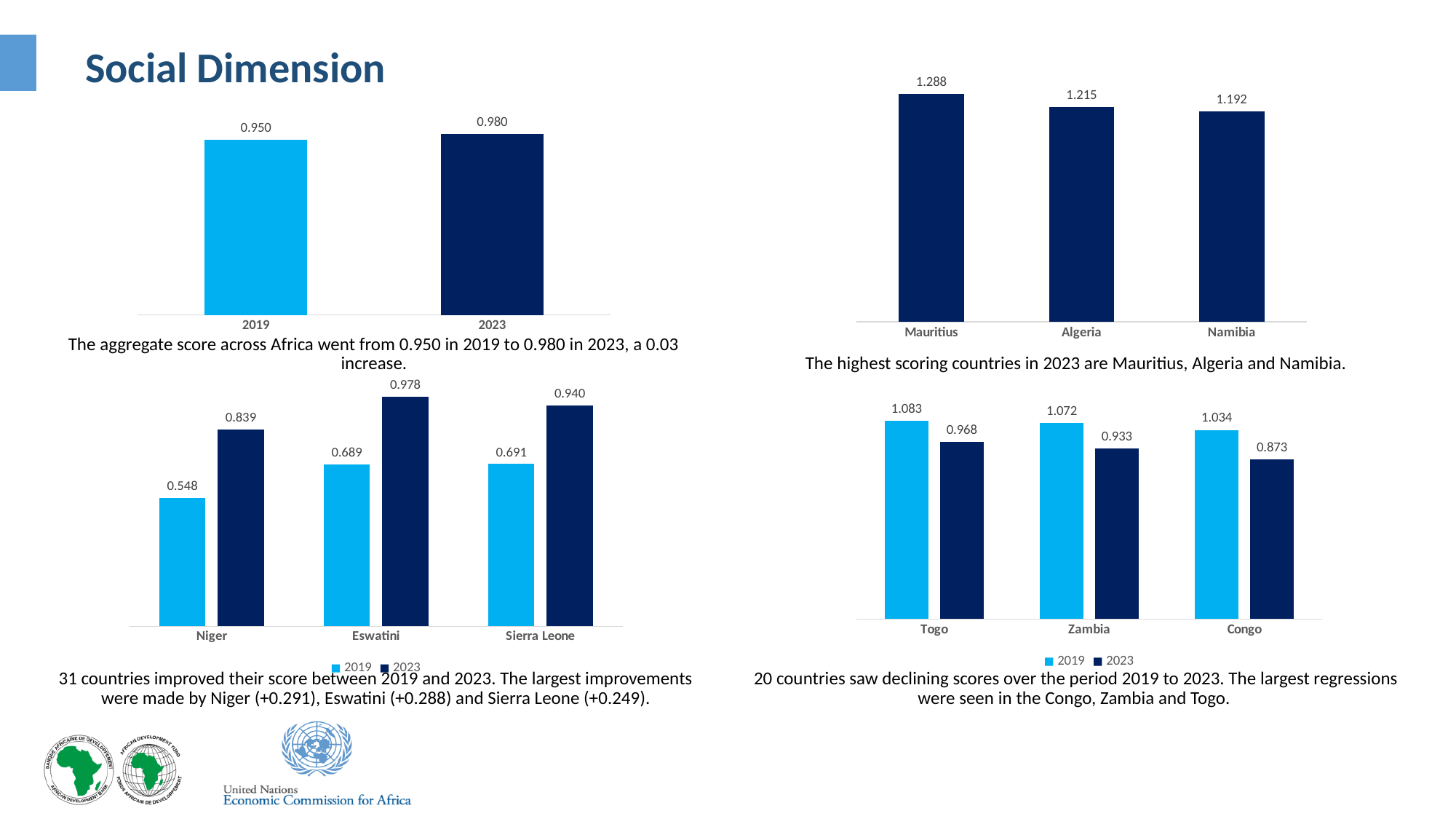
In the bottom-left chart, how many series does the legend list? 2 In the top-right chart, which country has the highest value? Mauritius In the bottom-right chart, what is the 2023 value for Congo? 0.873 In the bottom-left chart, what is the difference between the 2023 and 2019 values for Sierra Leone? 0.249 In the top-right chart, what is the value for Namibia? 1.192 In the bottom-left chart, which country has the highest 2023 value? Eswatini What kind of chart is the bottom-right chart? Bar chart In the top-left chart, what is the difference between the 2023 and 2019 values? 0.03 In the top-left chart, what is the aggregate score for 2023? 0.980 In the bottom-right chart, which is larger: the 2019 value for Togo or the 2019 value for Zambia? Togo In the top-right chart, how many countries are shown? 3 In the bottom-left chart, what is the 2019 value for Niger? 0.548